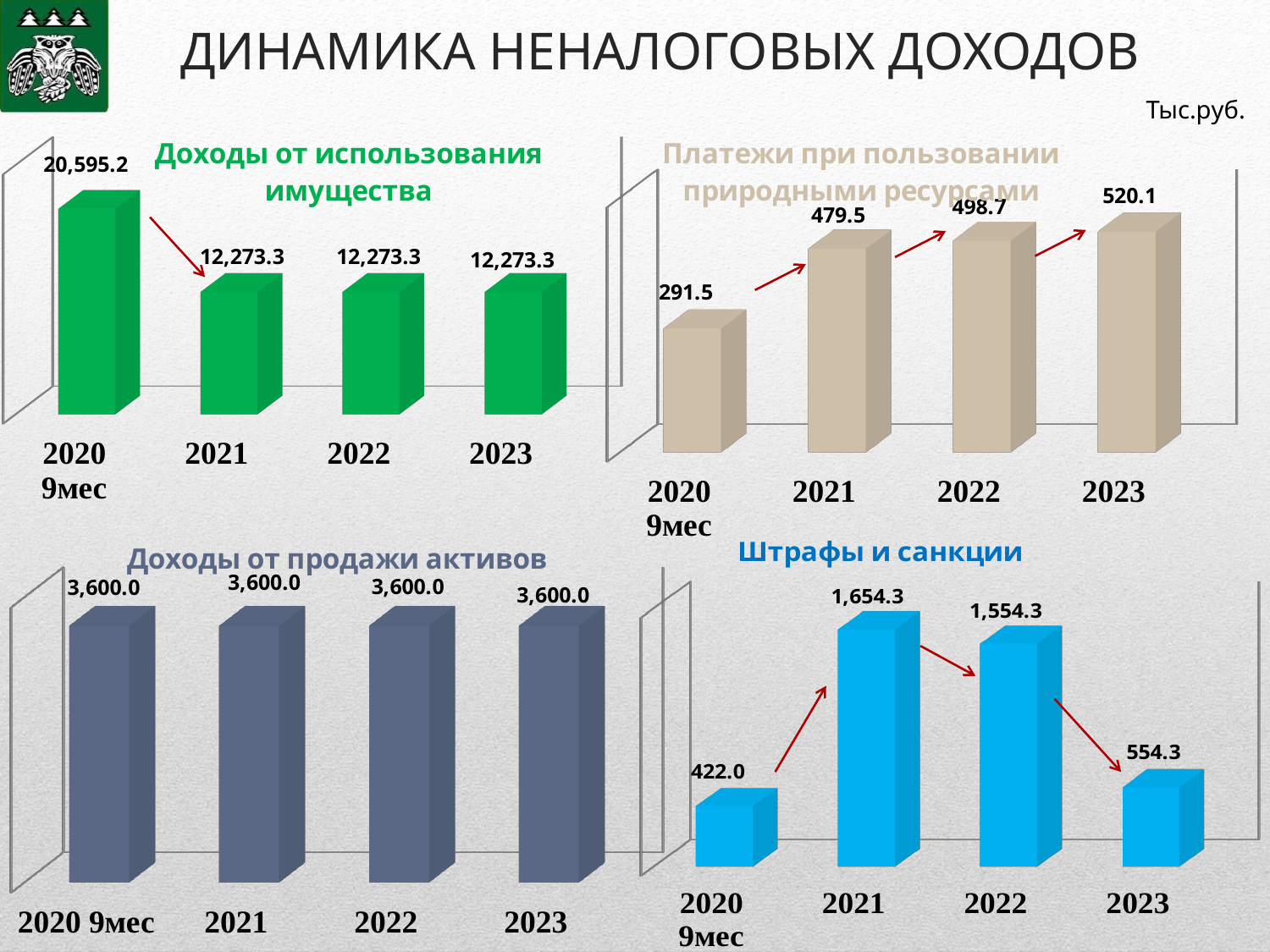
In the chart 'Доходы от использования имущества', what is the difference between the 2020 9мес value and the 2021 value? 8,321.9 In the chart 'Штрафы и санкции', which year has the lowest value? 2020 9мес What type of chart is 'Штрафы и санкции'? bar chart In the chart 'Платежи при пользовании природными ресурсами', do the values rise or fall from 2020 9мес to 2023? rise In the chart 'Платежи при пользовании природными ресурсами', what is the value for 2022? 498.7 In the chart 'Доходы от продажи активов', what is the value for 2022? 3,600.0 In the chart 'Платежи при пользовании природными ресурсами', which year has the highest value? 2023 In the chart 'Штрафы и санкции', what is the value for 2021? 1,654.3 In the chart 'Штрафы и санкции', what is the difference between the 2022 value and the 2023 value? 1,000.0 In the chart 'Доходы от использования имущества', what is the value for 2020 9мес? 20,595.2 In the chart 'Доходы от использования имущества', what is the value for 2023? 12,273.3 How many bars are shown in the chart 'Доходы от продажи активов'? 4